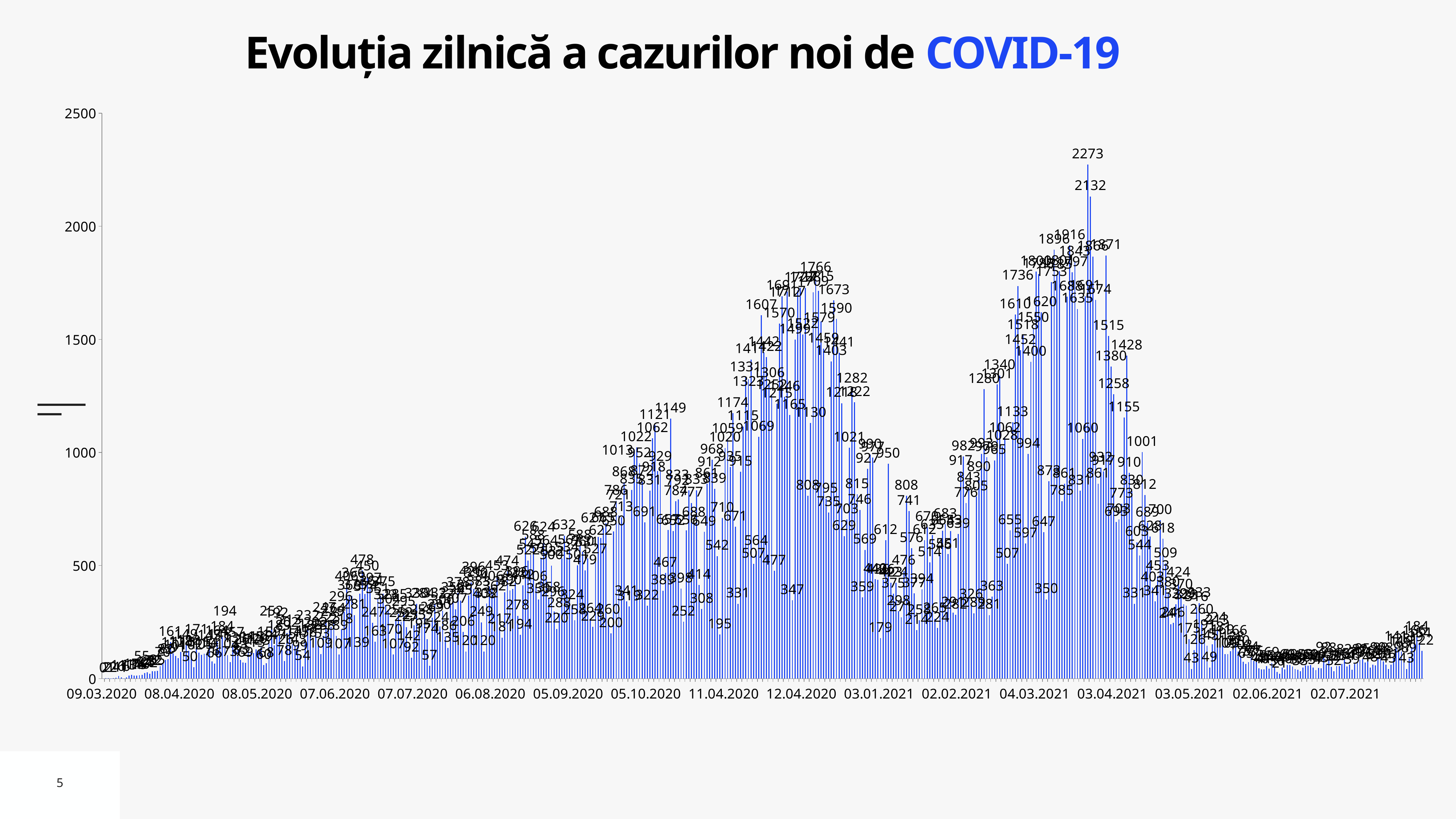
Are the values around 02.06.2021 greater or less than 500? less What is the difference between the two highest labelled values, 2273 and 2132? 141 What is the title of the chart? Evoluția zilnică a cazurilor noi de COVID-19 What is the maximum value shown on the y axis? 2500 Is the highest bar on the chart greater or less than 2000? greater What is the second-highest value labelled on the chart, next to the 2273 peak? 2132 Which peak is higher: the one near 12.04.2020 (labelled 1766) or the one near 03.04.2021 (labelled 2273)? the one near 03.04.2021 (2273) Do the values rise or fall between 09.03.2020 and 08.04.2020? rise How many date labels are shown on the x axis? 17 What is the highest daily value labelled on the chart? 2273 Do the values rise or fall between 03.04.2021 and 03.05.2021? fall What kind of chart is shown on the slide? bar chart